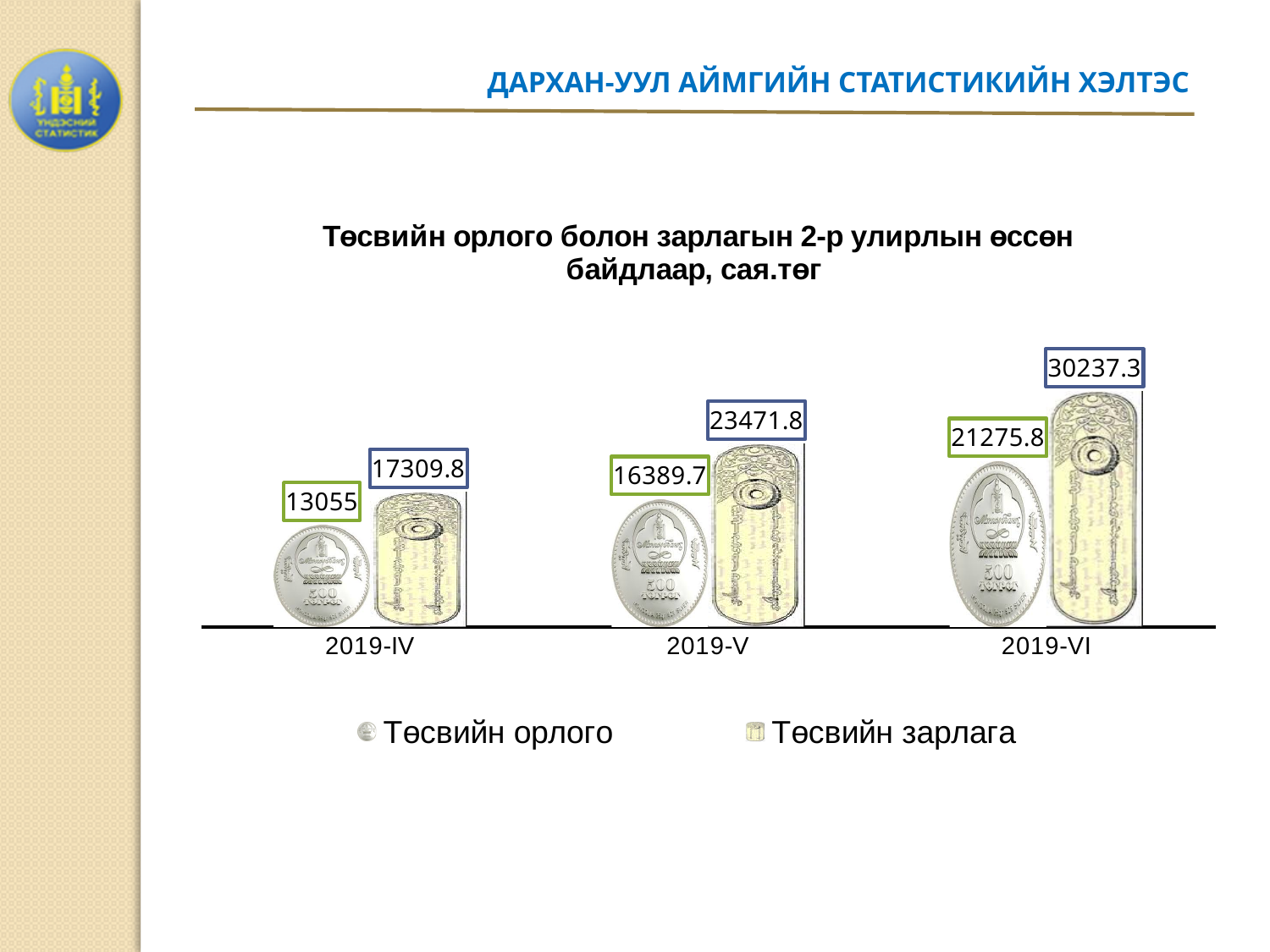
How many categories are shown on the x axis? 3 How many series does the legend list? 2 What is the value of Төсвийн зарлага for 2019-V? 23471.8 Which category has the highest value for Төсвийн зарлага? 2019-VI What is the difference between Төсвийн зарлага and Төсвийн орлого for 2019-VI? 8961.5 Which category has the lowest value for Төсвийн орлого? 2019-IV What is the value of Төсвийн зарлага for 2019-VI? 30237.3 What is the value of Төсвийн орлого for 2019-IV? 13055 Which is larger for 2019-V: Төсвийн орлого or Төсвийн зарлага? Төсвийн зарлага What is the value of Төсвийн орлого for 2019-V? 16389.7 Does Төсвийн орлого rise or fall from 2019-IV to 2019-VI? rise What is the difference between Төсвийн орлого for 2019-VI and for 2019-IV? 8220.8